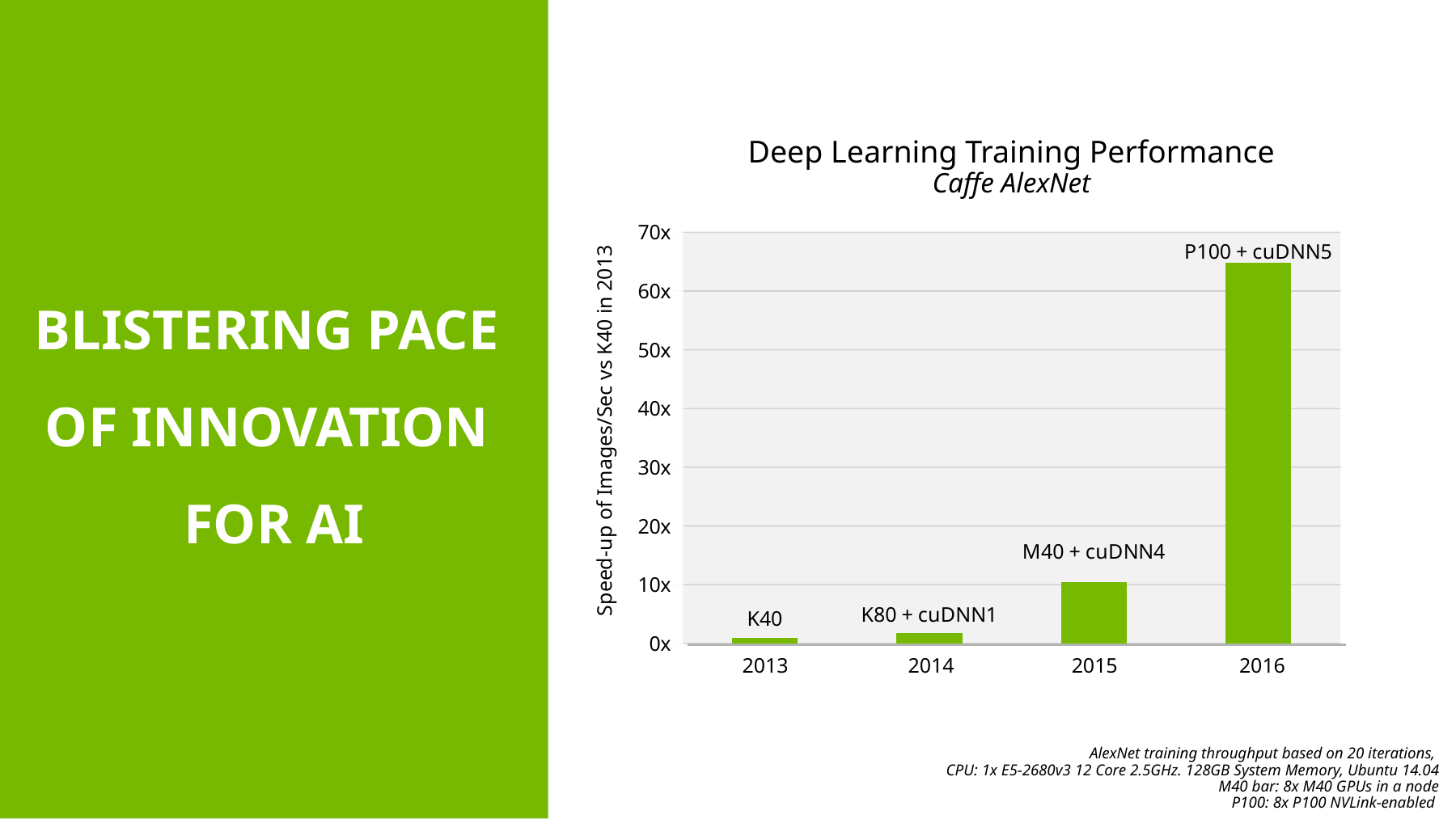
Is the speed-up for 2014 greater or less than 10x? less What is the label of the vertical axis? Speed-up of Images/Sec vs K40 in 2013 Which is larger, the speed-up for 2015 or for 2016? 2016 What kind of chart is shown on the slide? bar chart How many bars (years) are plotted in the chart? 4 Is the speed-up for 2015 greater or less than 20x? less Do the speed-up values rise or fall from 2013 to 2016? rise Is the speed-up for 2016 greater or less than 60x? greater What is the title of the chart? Deep Learning Training Performance Caffe AlexNet Which GPU configuration is labelled on the 2015 bar? M40 + cuDNN4 Which GPU configuration is labelled on the 2016 bar? P100 + cuDNN5 Which year has the highest speed-up in the chart? 2016